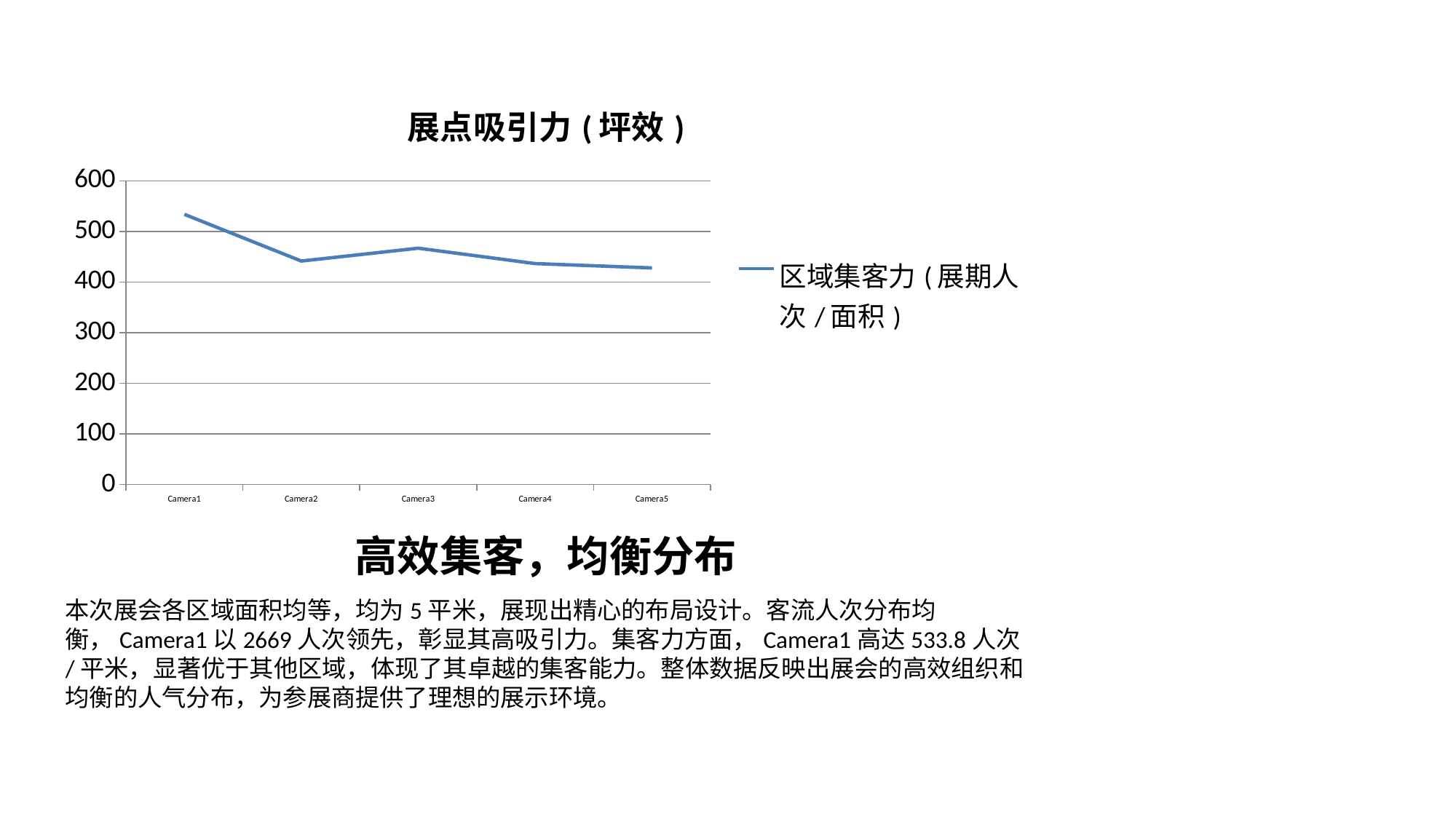
Is the value for Camera2 greater or less than 500? less Is the value for Camera5 greater or less than 500? less What is the title of the chart? 展点吸引力（坪效） Is the value for Camera3 greater or less than 400? greater What kind of chart is shown on the slide? line chart What series name does the legend show? 区域集客力（展期人次/面积） How many categories are plotted along the x axis? 5 How many series does the legend list? 1 Which is larger, the value for Camera1 or the value for Camera3? Camera1 Do the values generally rise or fall from Camera1 to Camera5? fall Which category has the highest value? Camera1